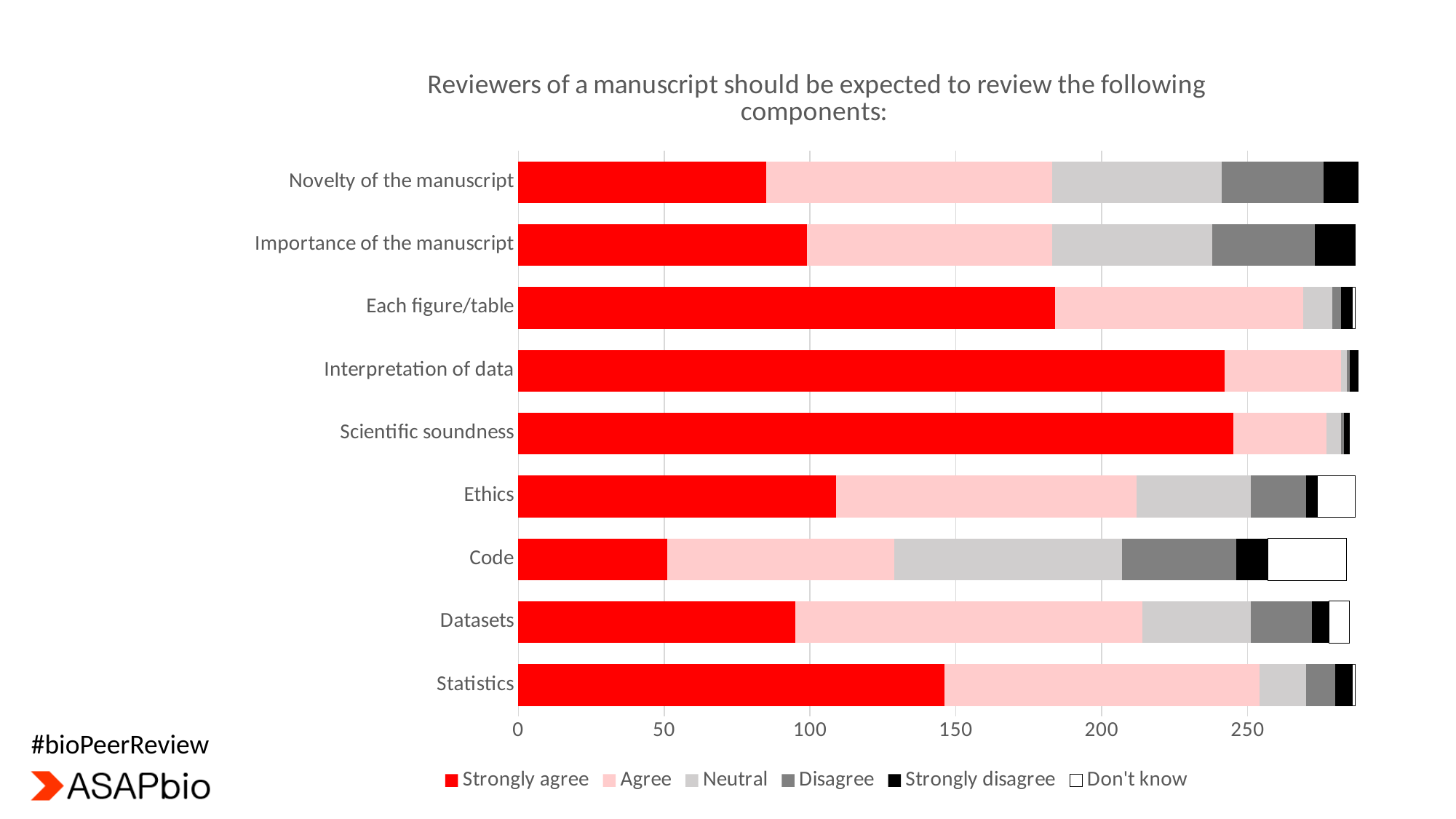
Is the 'Strongly agree' value for Each figure/table greater or less than 150? greater What is the title of the chart? Reviewers of a manuscript should be expected to review the following components: Is the 'Strongly agree' value for Novelty of the manuscript greater or less than 100? less How many components (categories) are listed on the vertical axis? 9 Is the 'Strongly agree' value for Code greater or less than 100? less Which legend entry is shown in black? Strongly disagree Which component has the smallest 'Strongly agree' segment? Code How many series does the legend list? 6 Which has a larger 'Strongly agree' segment, Code or Novelty of the manuscript? Novelty of the manuscript Which component has the largest 'Don't know' segment? Code What kind of chart is shown on the slide? Stacked bar chart